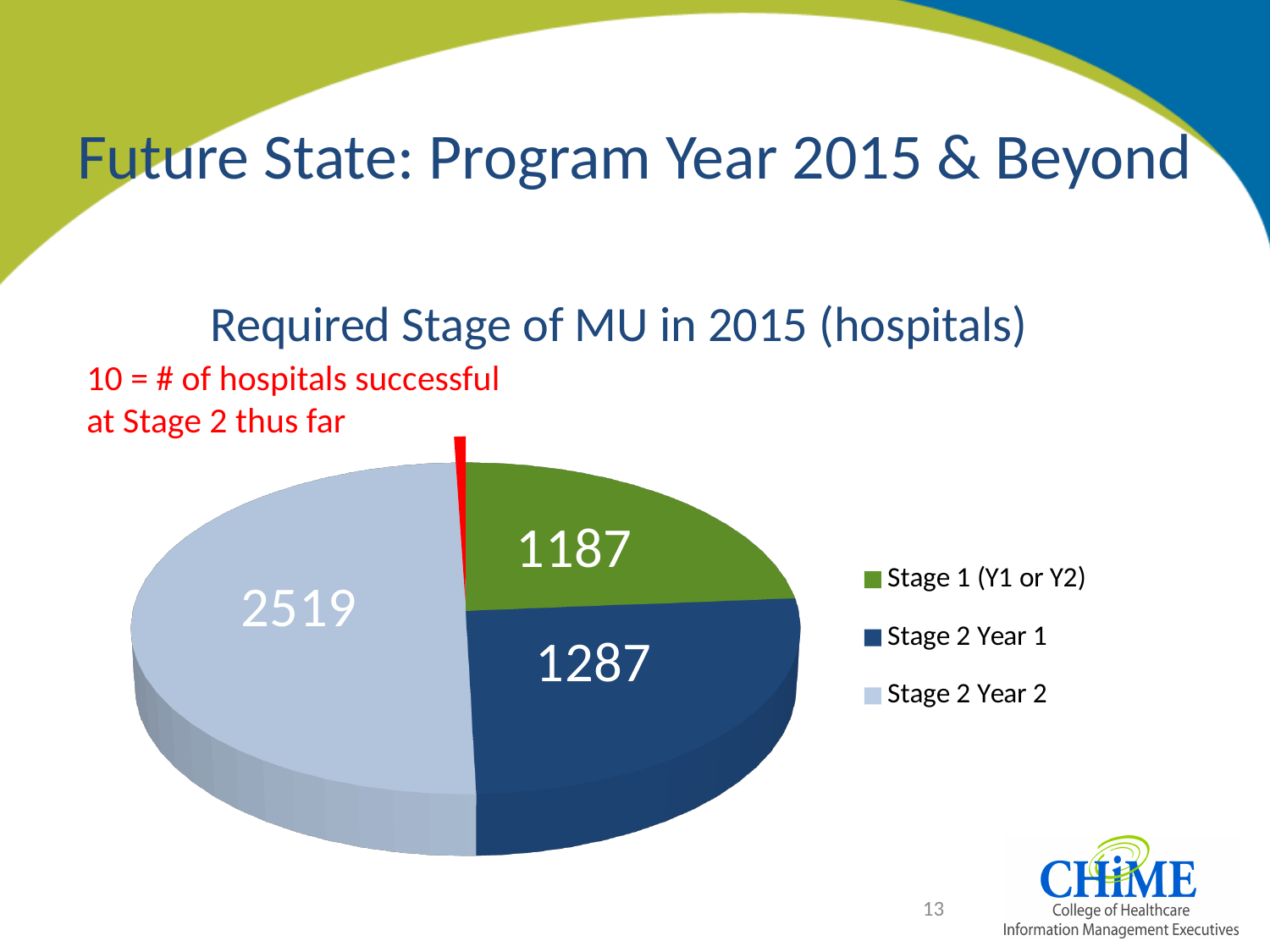
What is the value for Stage 2 Year 2? 2519 What is the difference between the values for Stage 2 Year 2 and Stage 2 Year 1? 1232 Which is larger, the value for Stage 2 Year 1 or the value for Stage 1 (Y1 or Y2)? Stage 2 Year 1 Which category has the largest slice of the pie? Stage 2 Year 2 What is the difference between the values for Stage 2 Year 1 and Stage 1 (Y1 or Y2)? 100 According to the red annotation, how many hospitals have been successful at Stage 2 thus far? 10 What is the value for Stage 2 Year 1? 1287 What is the title of the chart? Required Stage of MU in 2015 (hospitals) Which legend category has the smallest slice of the pie? Stage 1 (Y1 or Y2) What type of chart is shown on the slide? Pie chart How many entries does the chart legend list? 3 What is the value for Stage 1 (Y1 or Y2)? 1187